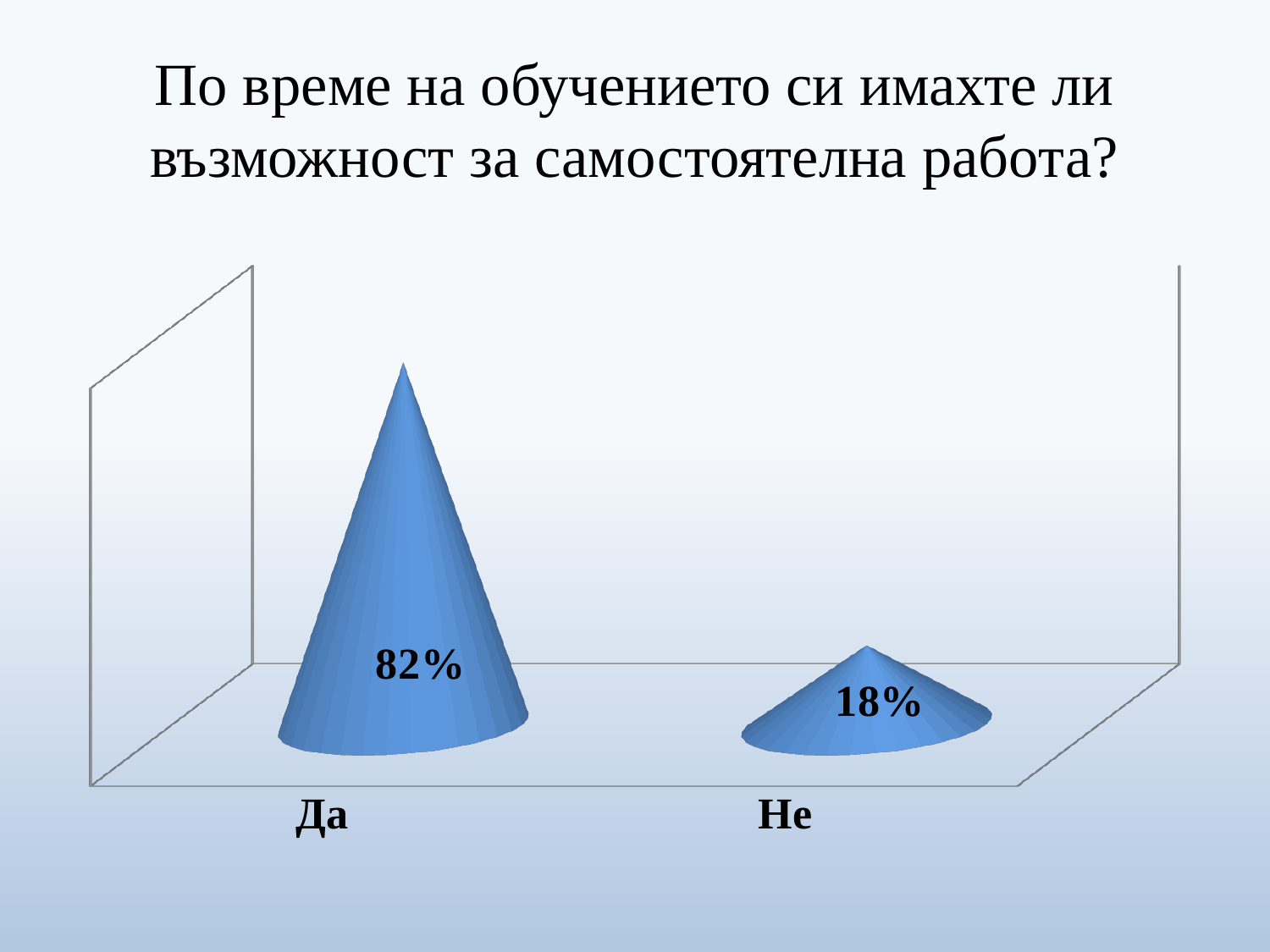
Which category has the lowest value? Не What kind of chart is shown on the slide? Bar chart What is the value for Не? 18% How many categories are shown on the chart? 2 Which is larger, the value for Да or the value for Не? Да What is the title of the slide containing the chart? По време на обучението си имахте ли възможност за самостоятелна работа? What colour are the bars on the chart? Blue Which category has the highest value? Да What is the value for Да? 82% What is the total of the two values shown on the chart? 100% What is the difference between the values for Да and Не? 64%